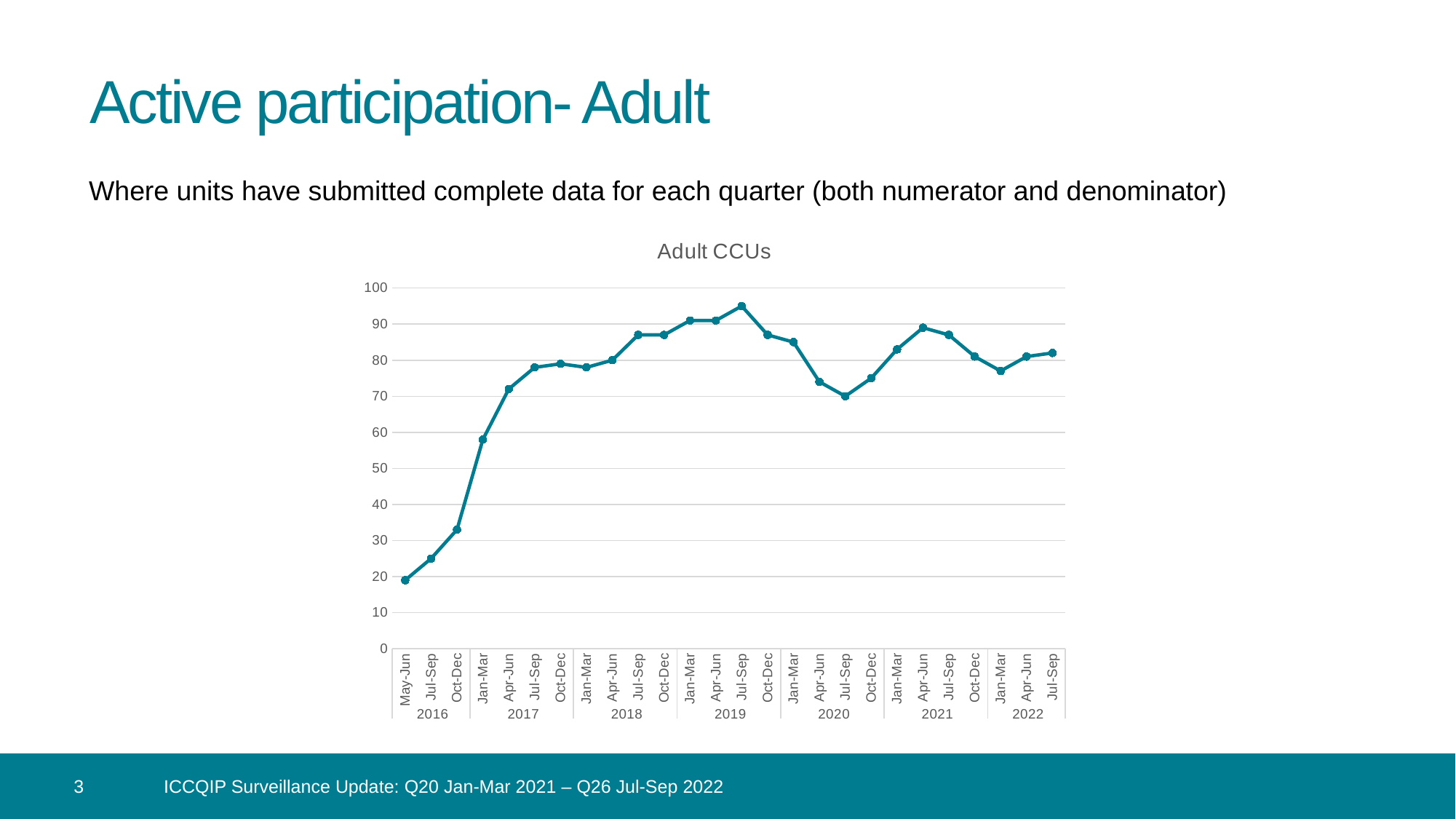
Is the value for Oct-Dec 2016 greater or less than 30? greater What is the title of the chart? Adult CCUs Do the values rise or fall from May-Jun 2016 to Jan-Mar 2018? rise Is the value for Apr-Jun 2020 greater or less than 80? less Which is larger, the value for Jul-Sep 2019 or the value for Apr-Jun 2021? Jul-Sep 2019 How many data points are plotted on the line? 26 Which quarter has the lowest value? May-Jun 2016 Is the value for Jan-Mar 2017 greater or less than 50? greater Which is larger, the value for Jan-Mar 2020 or the value for Jul-Sep 2020? Jan-Mar 2020 What kind of chart is shown on the slide? line chart Which quarter has the highest value? Jul-Sep 2019